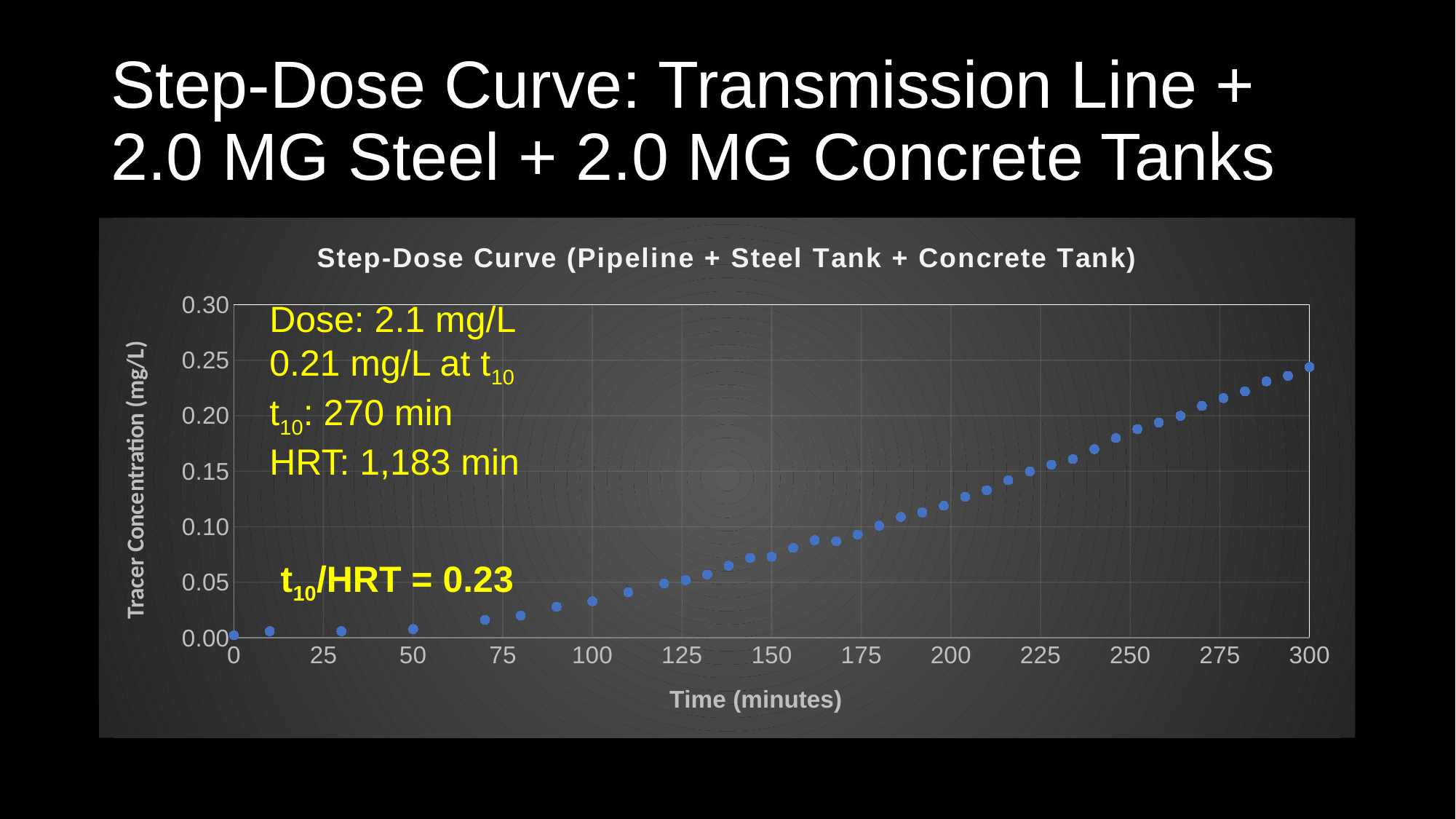
What kind of chart is shown on the slide? Scatter chart What is the label of the y axis? Tracer Concentration (mg/L) Is the tracer concentration at 200 minutes greater or less than 0.10 mg/L? greater According to the annotation on the chart, what is the t10 value? 270 min Is the tracer concentration at 300 minutes greater or less than 0.20 mg/L? greater Which has the larger tracer concentration, the point at 100 minutes or the point at 200 minutes? 200 minutes Is the tracer concentration at 150 minutes greater or less than 0.10 mg/L? less What is the title of the chart? Step-Dose Curve (Pipeline + Steel Tank + Concrete Tank) Do the tracer concentration values rise or fall as time increases along the x axis? Rise At which time on the x axis is the tracer concentration highest? 300 minutes